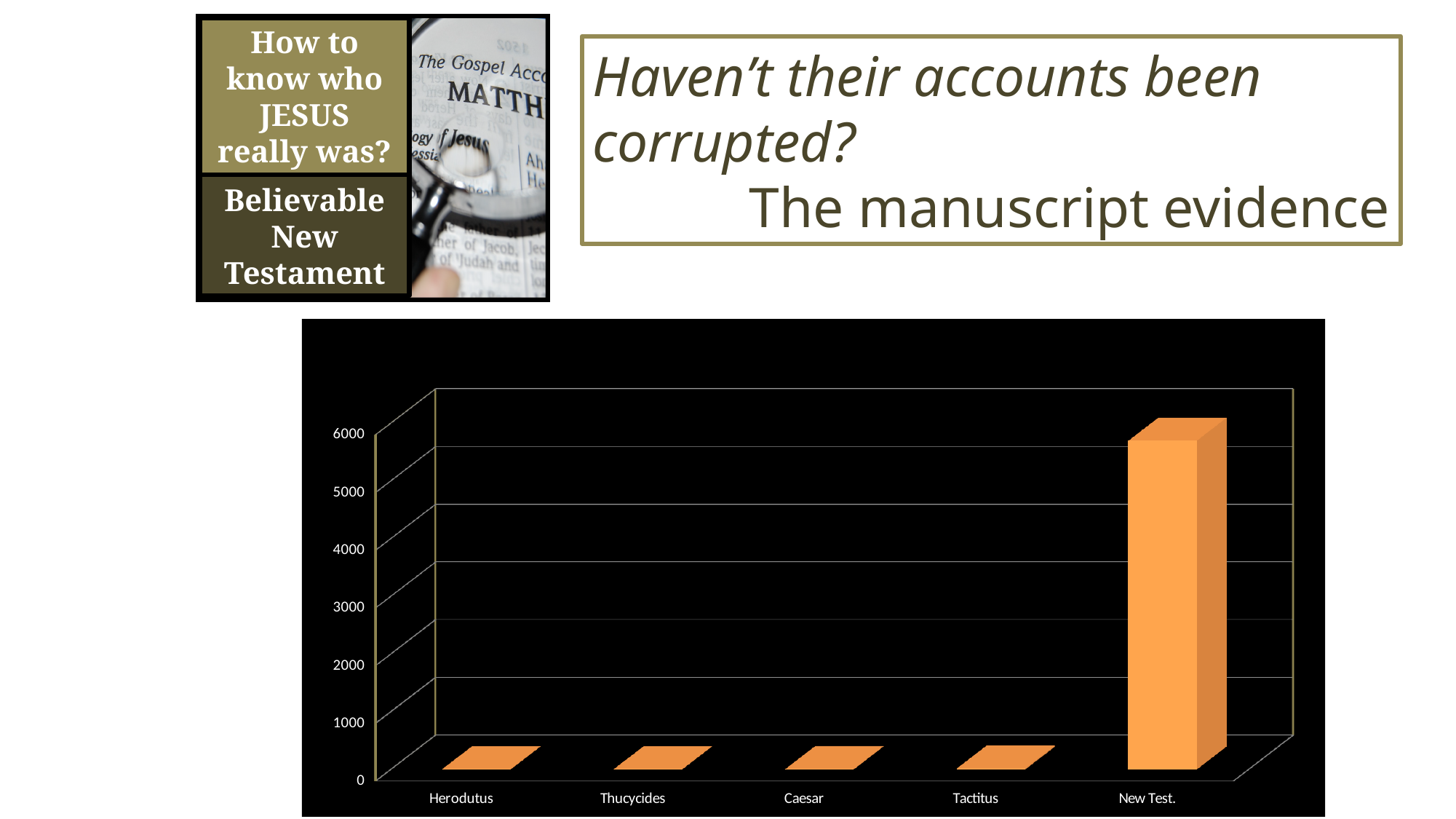
Is the value for New Test. greater or less than 5000? greater Which is larger, the value for Caesar or the value for New Test.? New Test. What kind of chart is shown on the slide? bar chart Is the value for New Test. greater or less than 4000? greater Which is larger, the value for New Test. or the value for Thucycides? New Test. Is the value for Tactitus greater or less than 2000? less How many categories are shown on the x axis of the chart? 5 What colour are the bars in the chart? orange Which category has the highest bar in the chart? New Test. What is the highest value labelled on the vertical axis of the chart? 6000